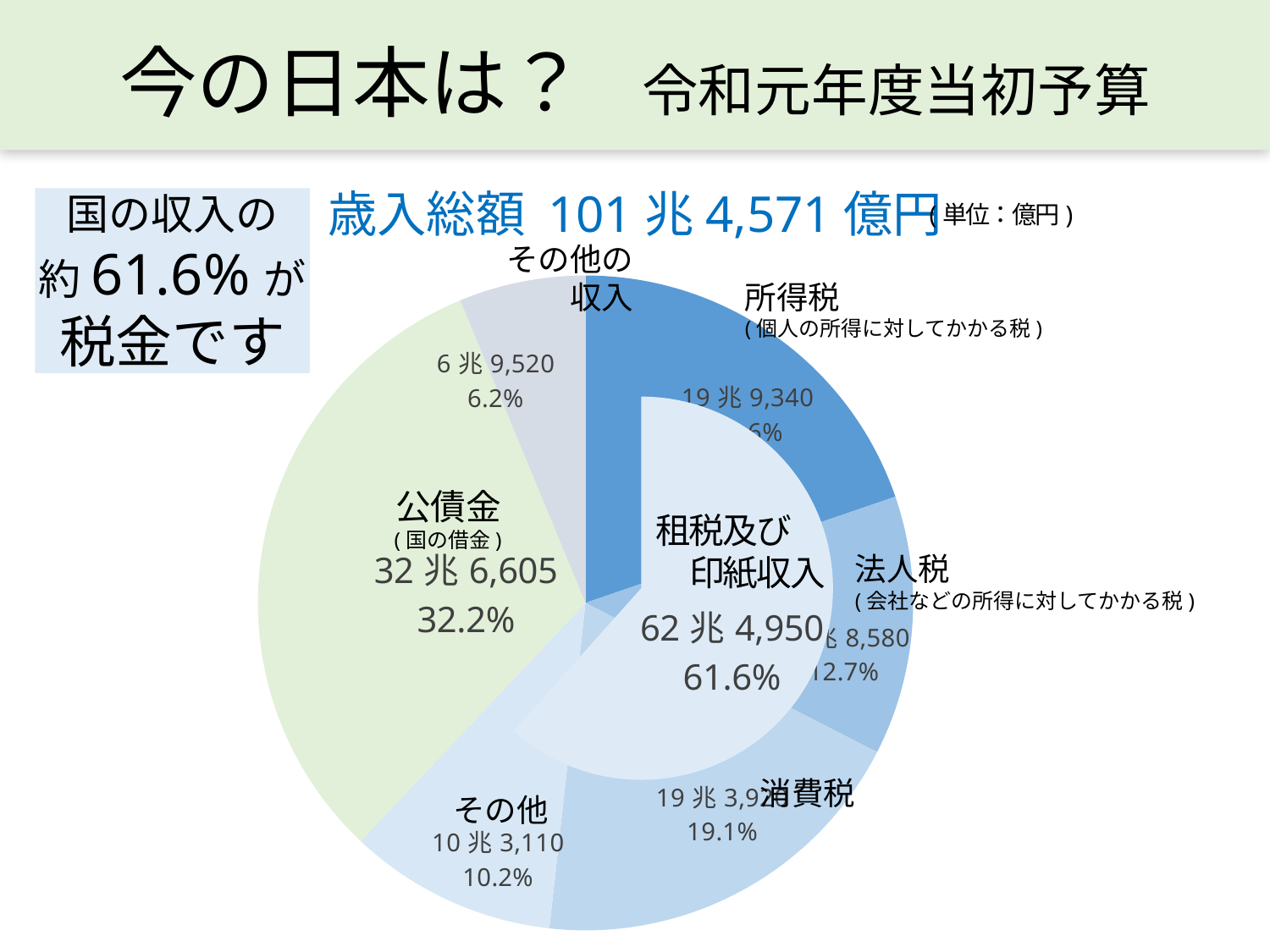
What percentage share does その他の収入 have in the pie chart? 6.2% Which slice of the pie chart is the smallest? その他の収入 What is the value shown for その他 in the pie chart? 10兆3,110 What is the value shown for その他の収入 in the pie chart? 6兆9,520 What is the value shown for 租税及び印紙収入 in the chart? 62兆4,950 What is the value shown for 公債金 (national debt) in the pie chart? 32兆6,605 What is the total revenue (歳入総額) stated above the pie chart? 101兆4,571億円 What kind of chart is shown on the slide? pie chart What percentage share does 消費税 have in the pie chart? 19.1% What percentage share does 法人税 have in the pie chart? 12.7%